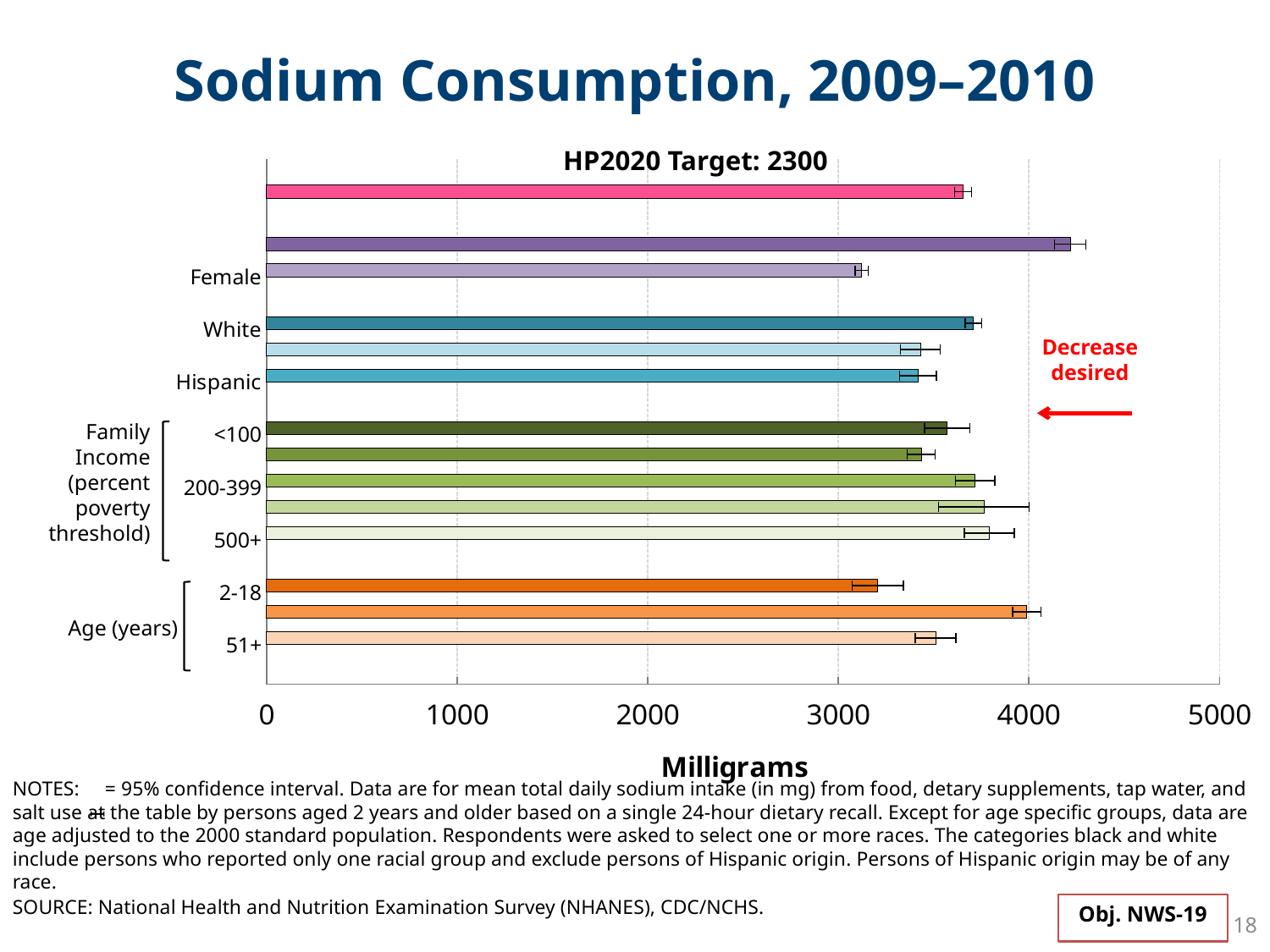
Is the value for White greater or less than 4000? less Is the value for Hispanic greater or less than 3000? greater Is the value for the 500+ family income group greater or less than 4000? less Which has the higher sodium consumption, White or Hispanic? White What kind of chart is shown on the slide? bar chart What unit is shown on the x axis of the chart? Milligrams Which has the higher sodium consumption, Female or White? White What is the HP2020 target value shown on the chart? 2300 Which has the higher sodium consumption, ages 2-18 or ages 51+? 51+